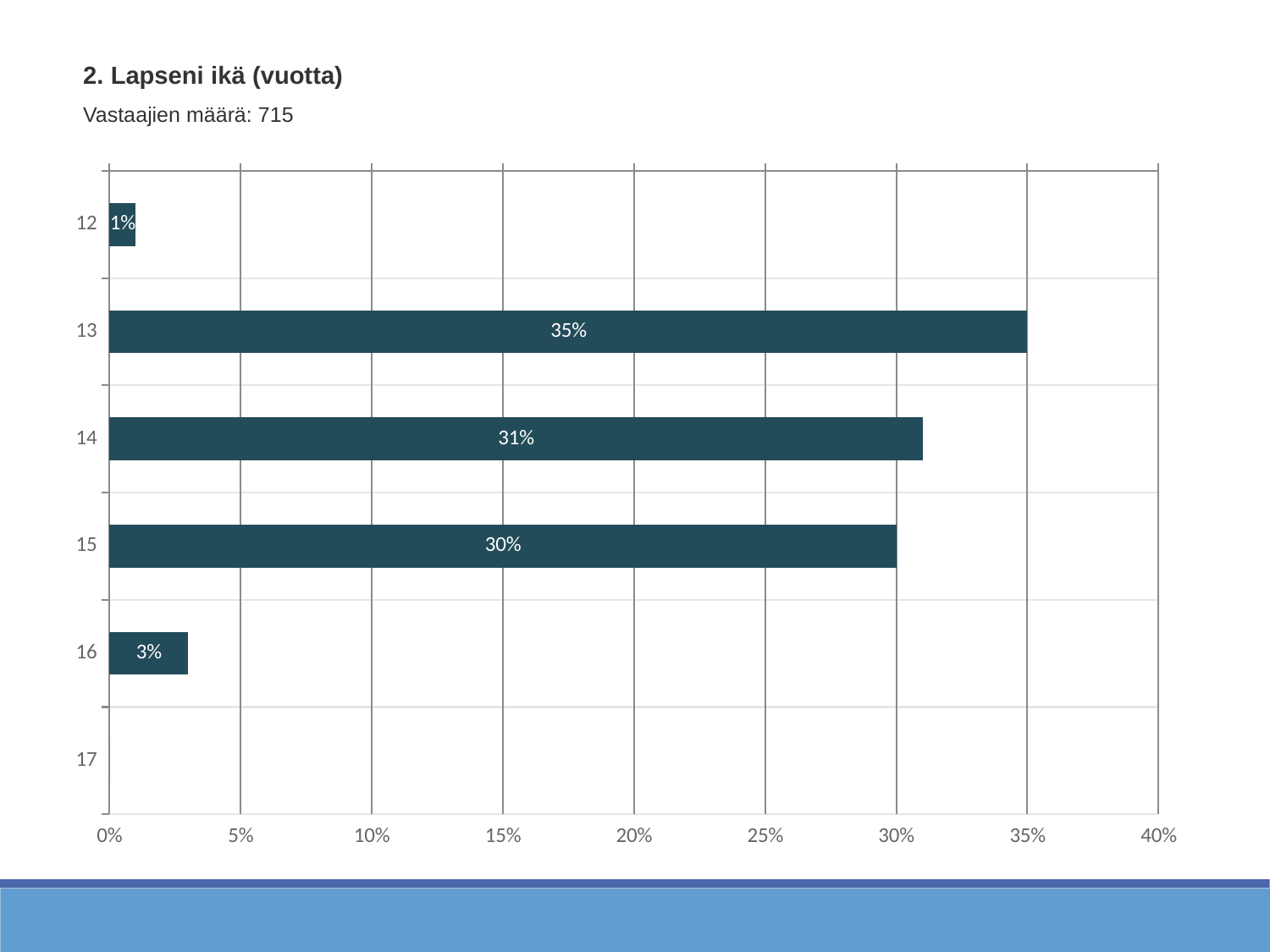
Is the value for age 15 greater or less than 20%? greater What is the difference in percentage points between age 13 and age 15? 5 What percentage is shown for age 12? 1% Which has a larger value, age 14 or age 16? 14 How many age categories are listed on the vertical axis? 6 What is the difference in percentage points between age 16 and age 12? 2 What percentage is shown for age 16? 3% Which age category has the highest percentage? 13 What kind of chart is shown on the slide? bar chart What percentage is shown for age 14? 31% What is the number of respondents (Vastaajien määrä) stated on the slide? 715 What percentage is shown for age 13? 35%